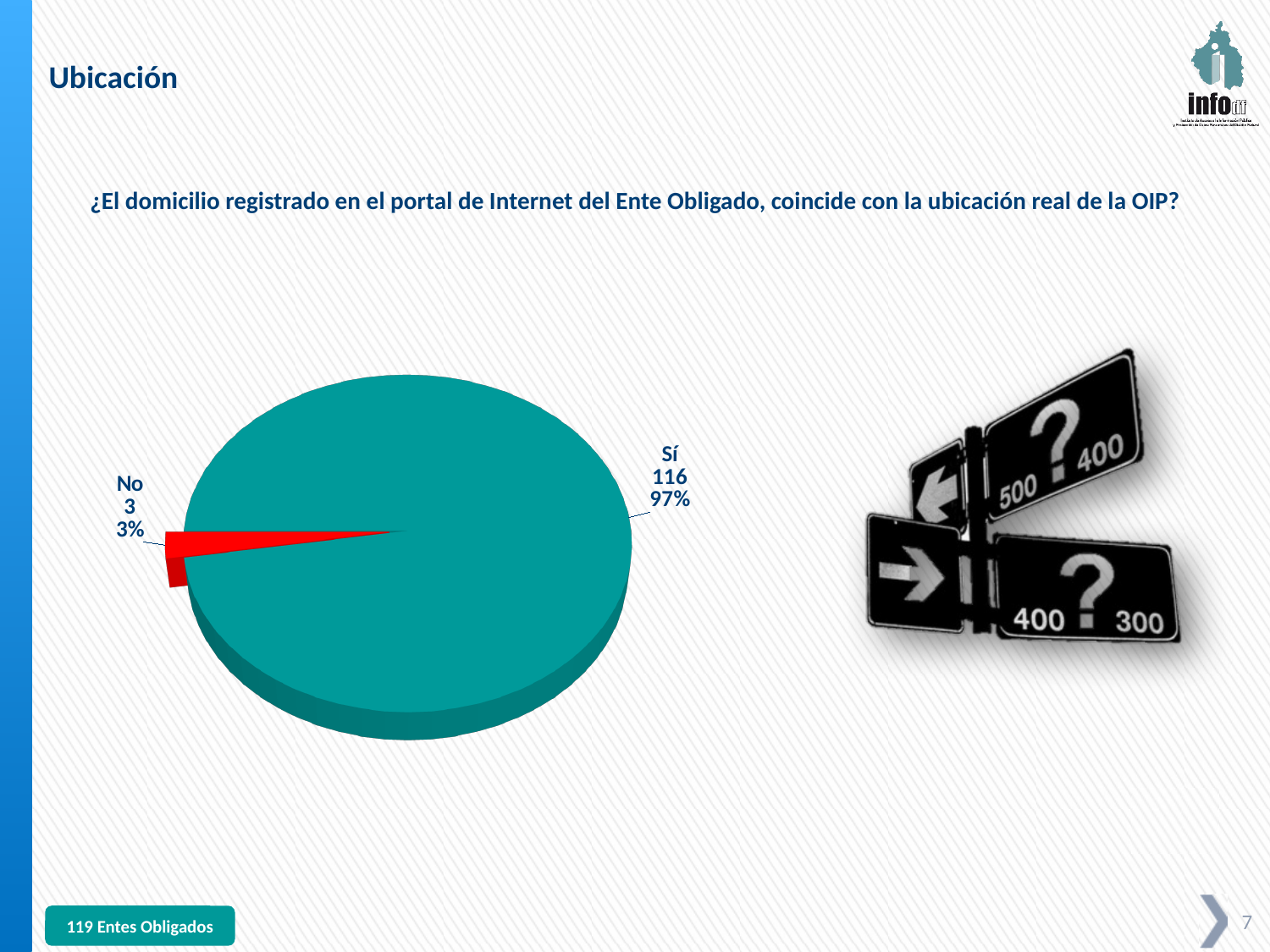
What percentage share does the "Sí" slice represent? 97% How many slices does the pie chart have? 2 What is the value for the "No" slice? 3 What colour is the "No" slice? red What is the difference between the "Sí" and "No" values? 113 What is the value for the "Sí" slice? 116 Which is larger, the value for "Sí" or the value for "No"? Sí What kind of chart is shown on the slide? pie chart What percentage share does the "No" slice represent? 3% What is the total of the two slices in the pie chart? 119 Which slice is the largest? Sí Which slice is the smallest? No